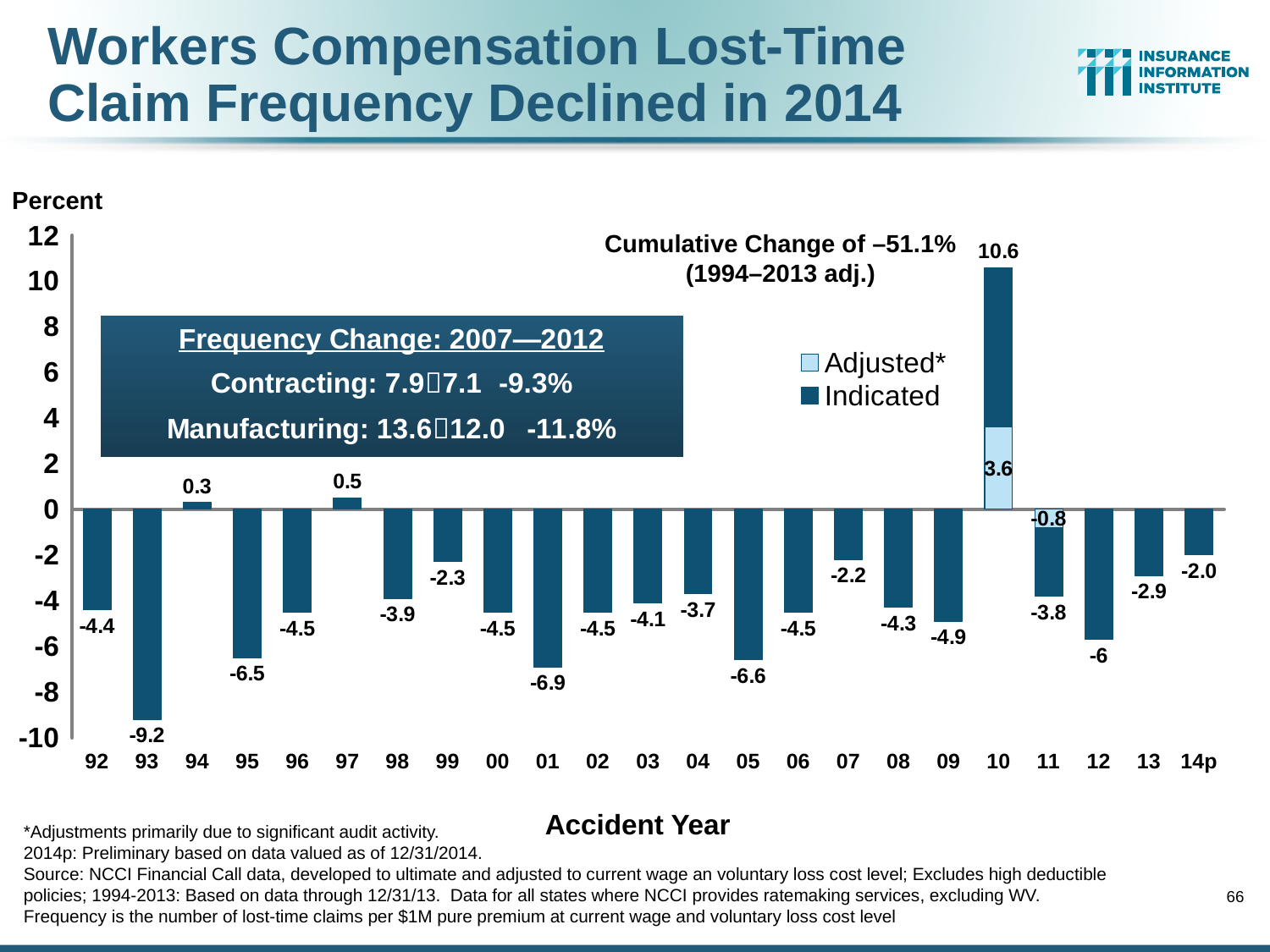
Which accident year has the highest value? 10 What is the Indicated value for accident year 10? 10.6 Which accident year has the lowest value? 93 What kind of chart is shown on the slide? Bar chart What is the value for accident year 14p? -2.0 How many accident years are shown on the x axis? 23 Which is larger, the value for accident year 94 or for accident year 97? 97 What is the value for accident year 93? -9.2 What is the Adjusted value for accident year 10? 3.6 What is the difference between the values for accident years 12 and 13? 3.1 What is the Adjusted value for accident year 11? -0.8 How many series does the legend list? 2